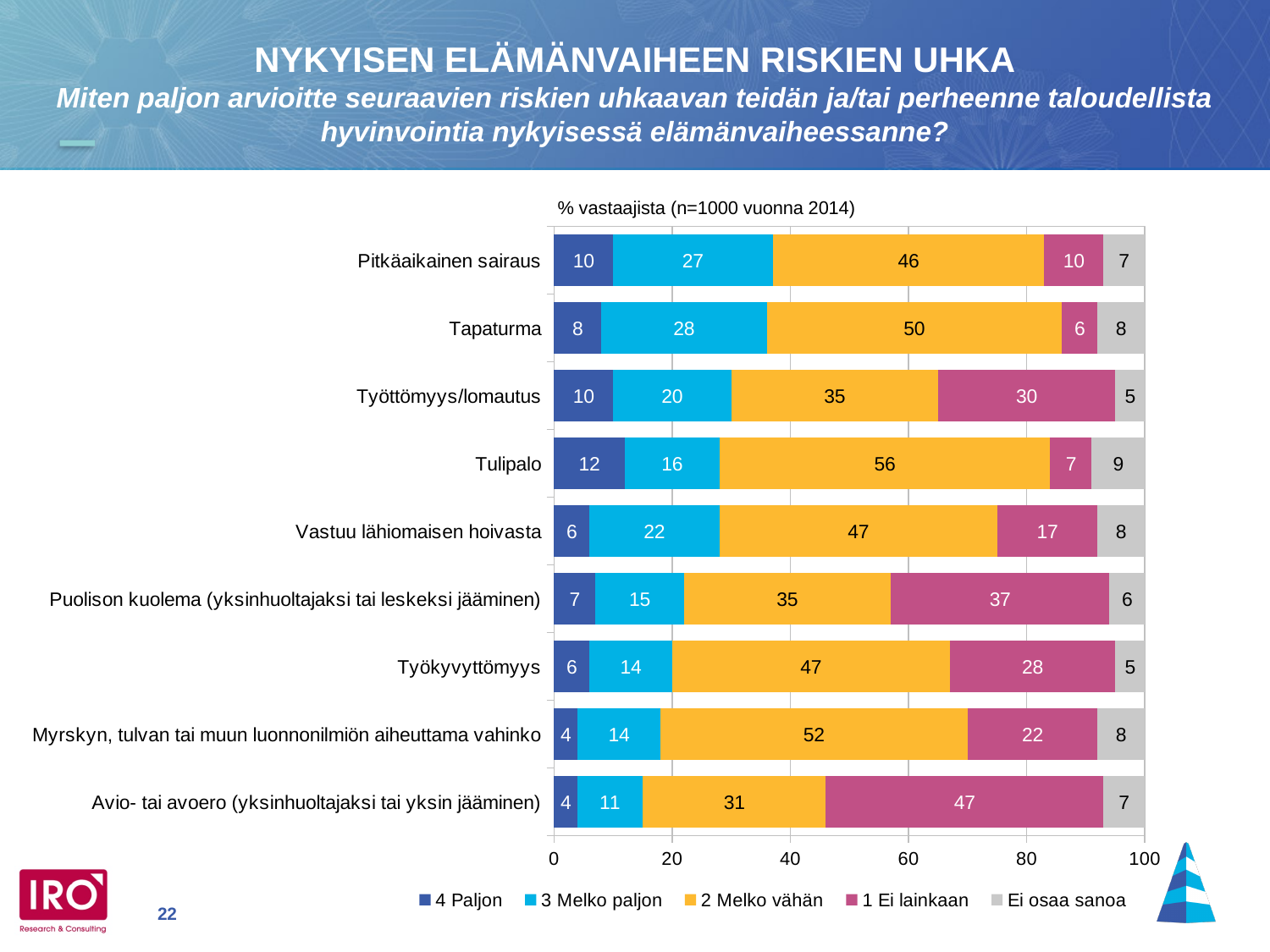
What is the last entry in the chart's legend? Ei osaa sanoa What is the total of the stacked bar for Pitkäaikainen sairaus? 100 What is the value of "3 Melko paljon" for Vastuu lähiomaisen hoivasta? 22 What kind of chart is shown on the slide? Stacked bar chart Which is larger: the "1 Ei lainkaan" value for Puolison kuolema (yksinhuoltajaksi tai leskeksi jääminen) or for Työkyvyttömyys? Puolison kuolema (yksinhuoltajaksi tai leskeksi jääminen) How many categories (risks) are shown on the chart? 9 Which category has the highest value for "4 Paljon"? Tulipalo What is the difference between the "2 Melko vähän" values for Tulipalo and Työttömyys/lomautus? 21 How many series does the legend list? 5 Which category has the lowest value for "1 Ei lainkaan"? Tapaturma What is the value of "1 Ei lainkaan" for Avio- tai avoero (yksinhuoltajaksi tai yksin jääminen)? 47 What is the value of "2 Melko vähän" for Tapaturma? 50